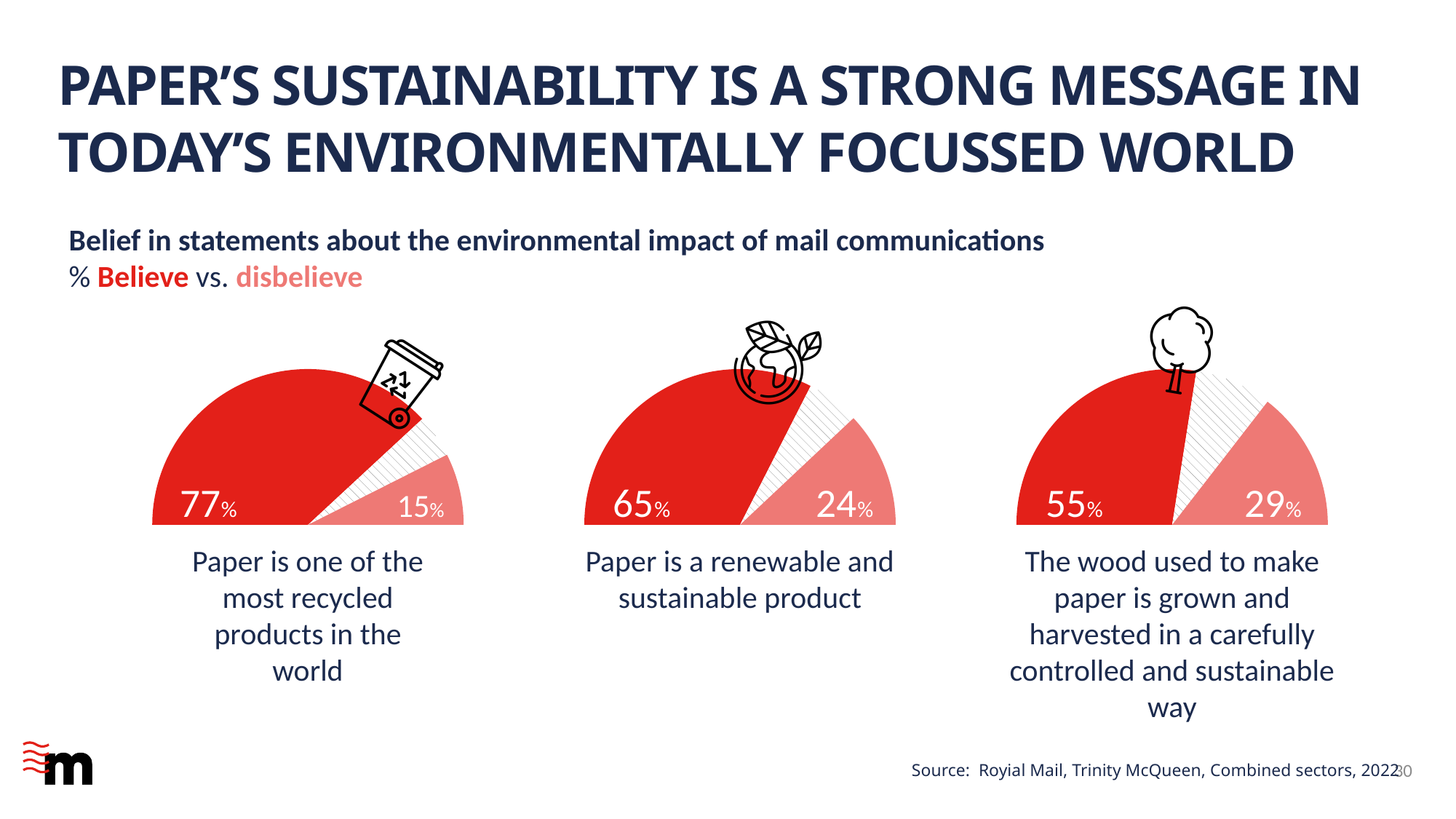
What percentage disbelieve the statement "Paper is one of the most recycled products in the world"? 15% What percentage disbelieve the statement "Paper is a renewable and sustainable product"? 24% What percentage believe the statement "Paper is a renewable and sustainable product"? 65% What percentage disbelieve the statement that the wood used to make paper is grown and harvested in a carefully controlled and sustainable way? 29% For the statement "Paper is one of the most recycled products in the world", how many percentage points higher is the believe share than the disbelieve share? 62 percentage points Which statement has the lowest percentage of people who believe it? The wood used to make paper is grown and harvested in a carefully controlled and sustainable way What percentage believe the statement "Paper is one of the most recycled products in the world"? 77% Which statement has the highest percentage of people who disbelieve it? The wood used to make paper is grown and harvested in a carefully controlled and sustainable way Which colour represents the "Believe" share in the charts? Red What percentage believe the statement that the wood used to make paper is grown and harvested in a carefully controlled and sustainable way? 55% Which statement has the highest percentage of people who believe it? Paper is one of the most recycled products in the world How many statements about the environmental impact of mail communications are charted on the slide? 3